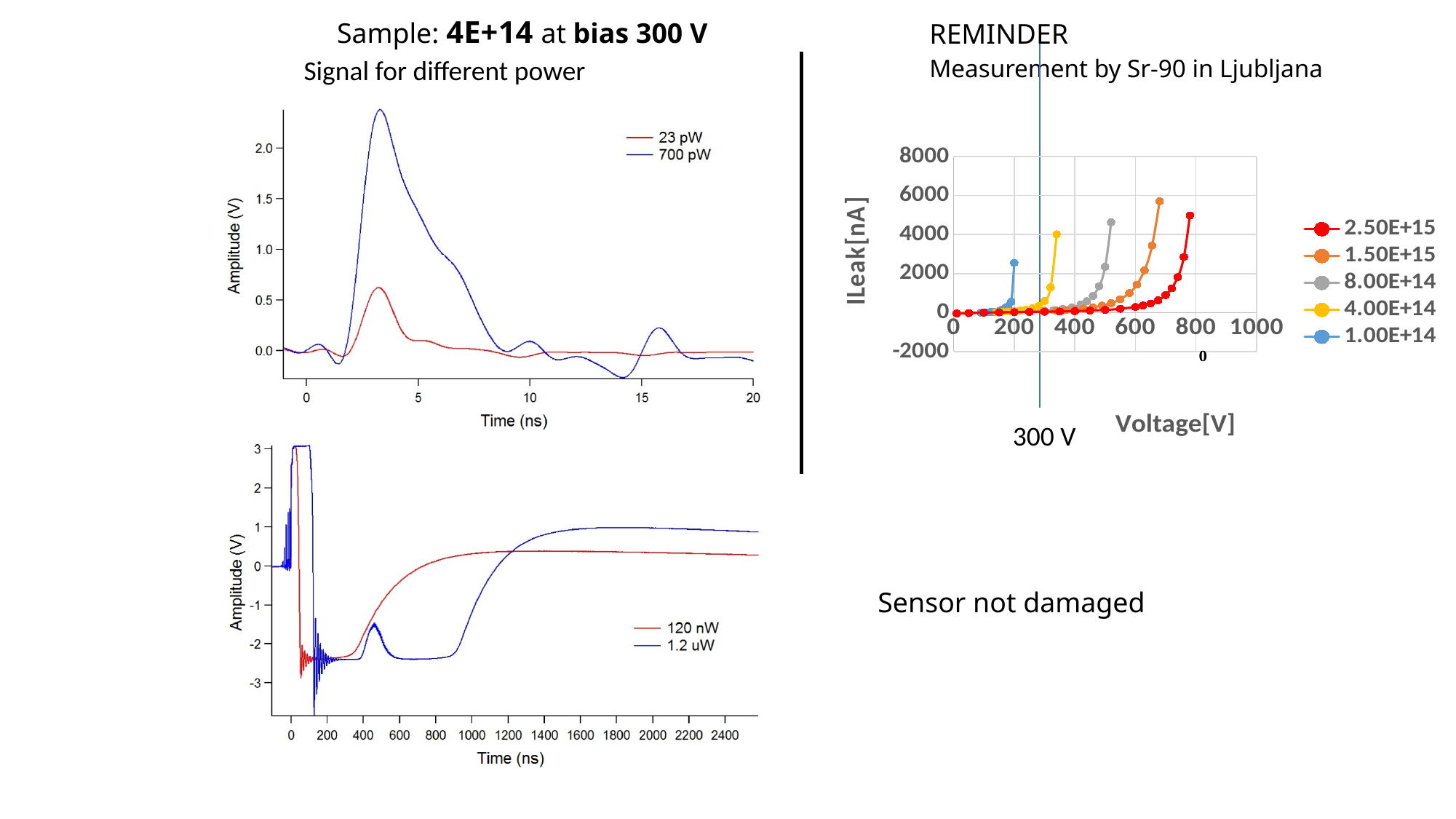
What kind of chart is the top-left 'Signal for different power' chart? line chart In the right-hand ILeak vs Voltage chart, is the highest ILeak value of the 1.50E+15 series greater or less than 4000 nA? greater In the top-left chart, is the peak amplitude of the 23 pW series greater or less than 1.0 V? less What is the x-axis label of the right-hand chart? Voltage[V] In the right-hand ILeak vs Voltage chart, which series extends to the highest voltage before its steep rise? 2.50E+15 In the bottom-left chart, is the amplitude of the 120 nW series at 2000 ns greater or less than 1 V? less In the bottom-left chart, which series settles at the higher amplitude after 1600 ns, 120 nW or 1.2 uW? 1.2 uW How many series does the legend of the top-left chart list? 2 How many series does the legend of the right-hand ILeak vs Voltage chart list? 5 In the right-hand ILeak vs Voltage chart, which series rises steeply at the lowest voltage? 1.00E+14 In the top-left chart, which series reaches the higher peak amplitude, 23 pW or 700 pW? 700 pW